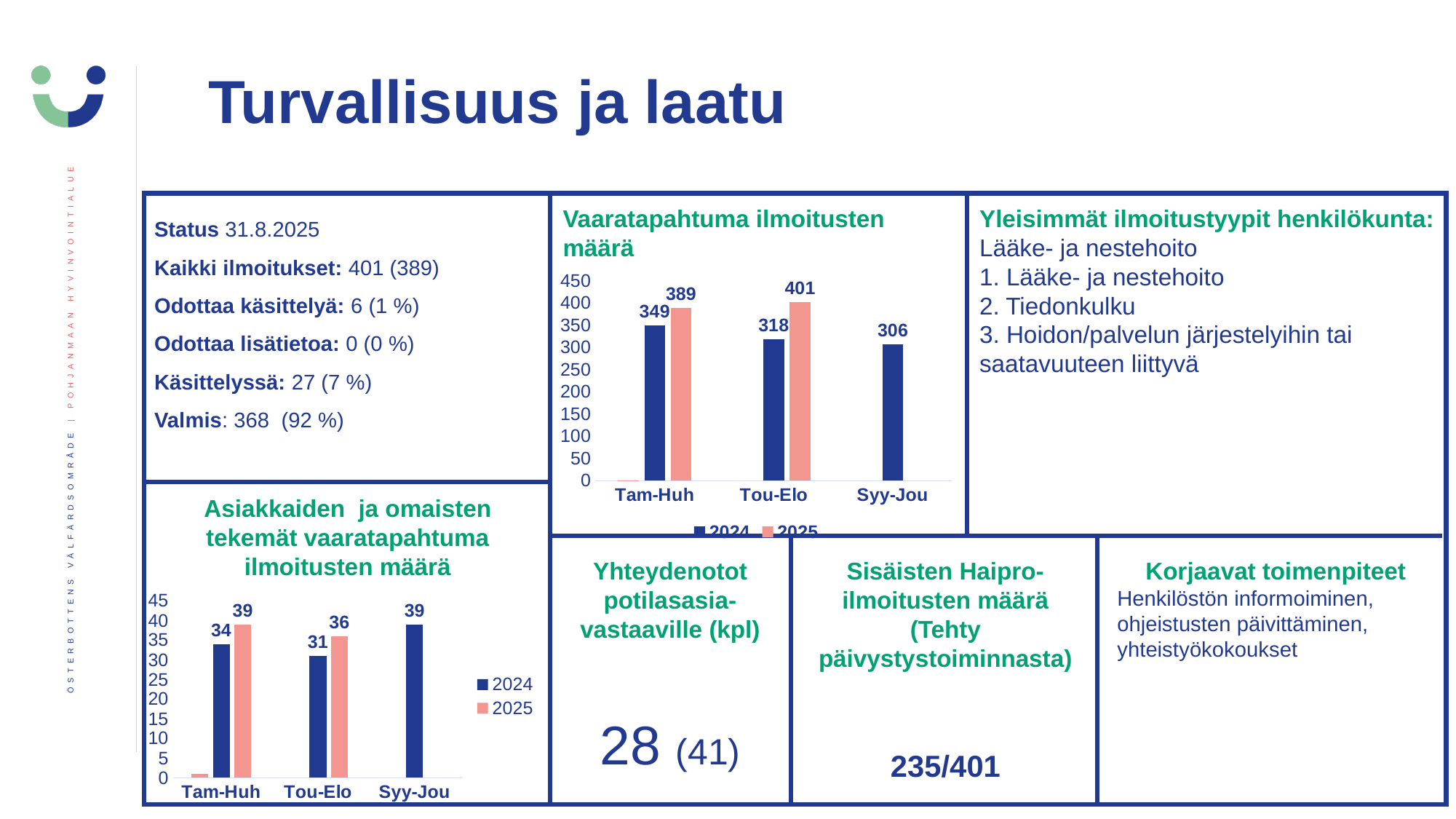
In the 'Vaaratapahtuma ilmoitusten määrä' chart, which is larger for Tou-Elo: the 2024 value or the 2025 value? 2025 In the 'Asiakkaiden ja omaisten tekemät vaaratapahtuma ilmoitusten määrä' chart, what is the difference between the 2025 and 2024 values for Tou-Elo? 5 In the 'Vaaratapahtuma ilmoitusten määrä' chart, what is the 2025 value for Tou-Elo? 401 In the 'Asiakkaiden ja omaisten tekemät vaaratapahtuma ilmoitusten määrä' chart, which period has the highest 2024 value? Syy-Jou In the 'Vaaratapahtuma ilmoitusten määrä' chart, which period has the lowest 2024 value? Syy-Jou In the 'Asiakkaiden ja omaisten tekemät vaaratapahtuma ilmoitusten määrä' chart, what is the 2024 value for Tou-Elo? 31 How many periods are shown on the x axis of the 'Asiakkaiden ja omaisten tekemät vaaratapahtuma ilmoitusten määrä' chart? 3 What kind of chart is the 'Vaaratapahtuma ilmoitusten määrä' chart? Bar chart In the 'Vaaratapahtuma ilmoitusten määrä' chart, what is the 2024 value for Syy-Jou? 306 In the 'Vaaratapahtuma ilmoitusten määrä' chart, what is the difference between the 2025 and 2024 values for Tam-Huh? 40 How many series does the legend of the 'Vaaratapahtuma ilmoitusten määrä' chart list? 2 In the 'Asiakkaiden ja omaisten tekemät vaaratapahtuma ilmoitusten määrä' chart, what is the 2025 value for Tam-Huh? 39